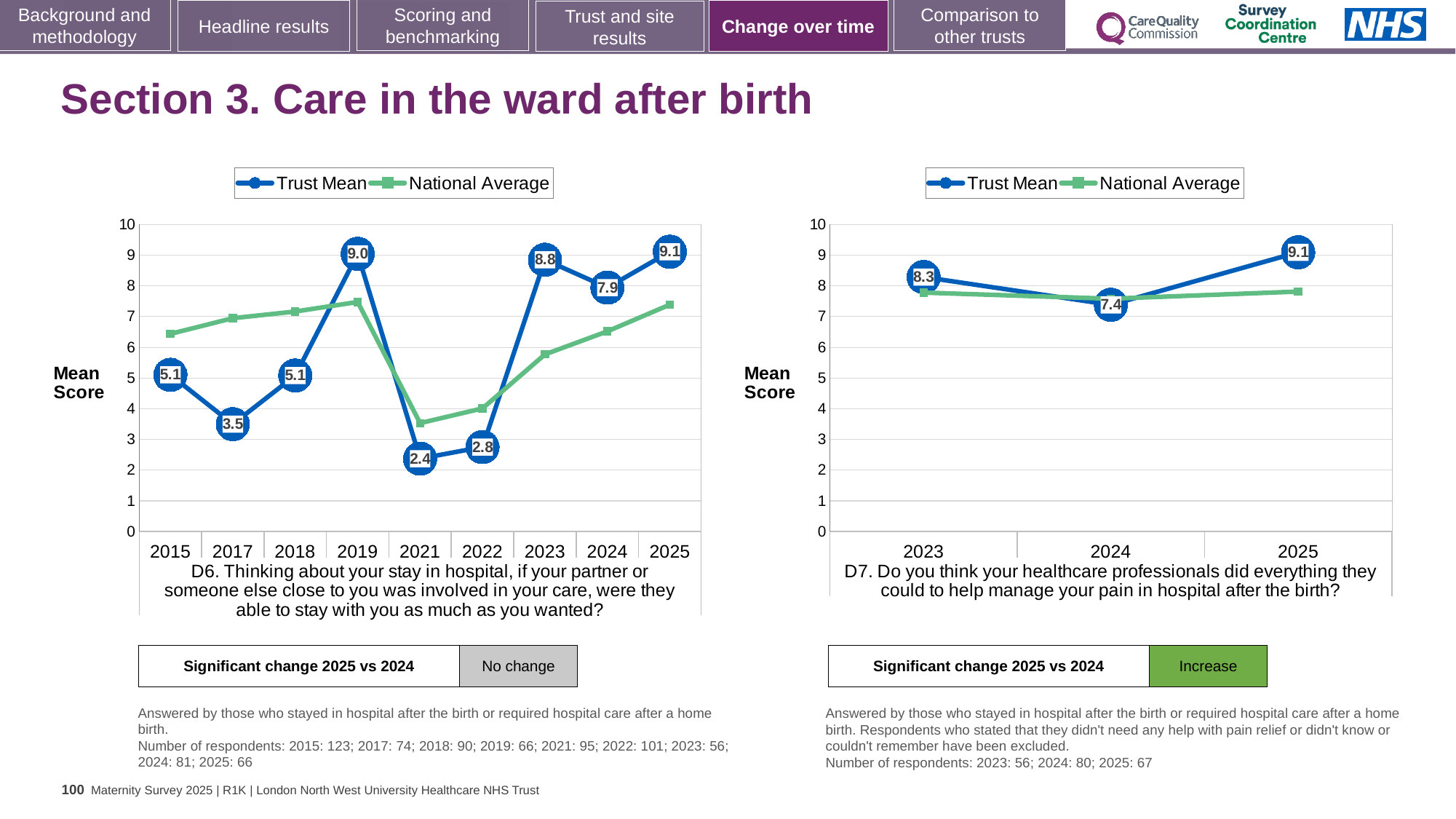
In the left chart (D6), is the National Average for 2015 greater or less than 6? greater In the left chart (D6), what is the Trust Mean for 2019? 9.0 In the left chart (D6), what is the difference between the Trust Mean for 2025 and 2024? 1.2 In the left chart (D6), which year has the highest Trust Mean? 2025 In the left chart (D6), how many years are plotted on the x axis? 9 In the left chart (D6), what is the Trust Mean for 2021? 2.4 In the right chart (D7), which is larger, the Trust Mean for 2023 or for 2025? 2025 In the right chart (D7), what is the Trust Mean for 2024? 7.4 In the left chart (D6), which year has the lowest Trust Mean? 2021 In the right chart (D7), what is the difference between the Trust Mean for 2025 and 2023? 0.8 What kind of chart is the left chart (D6)? Line chart How many series does the legend of the right chart (D7) list? 2